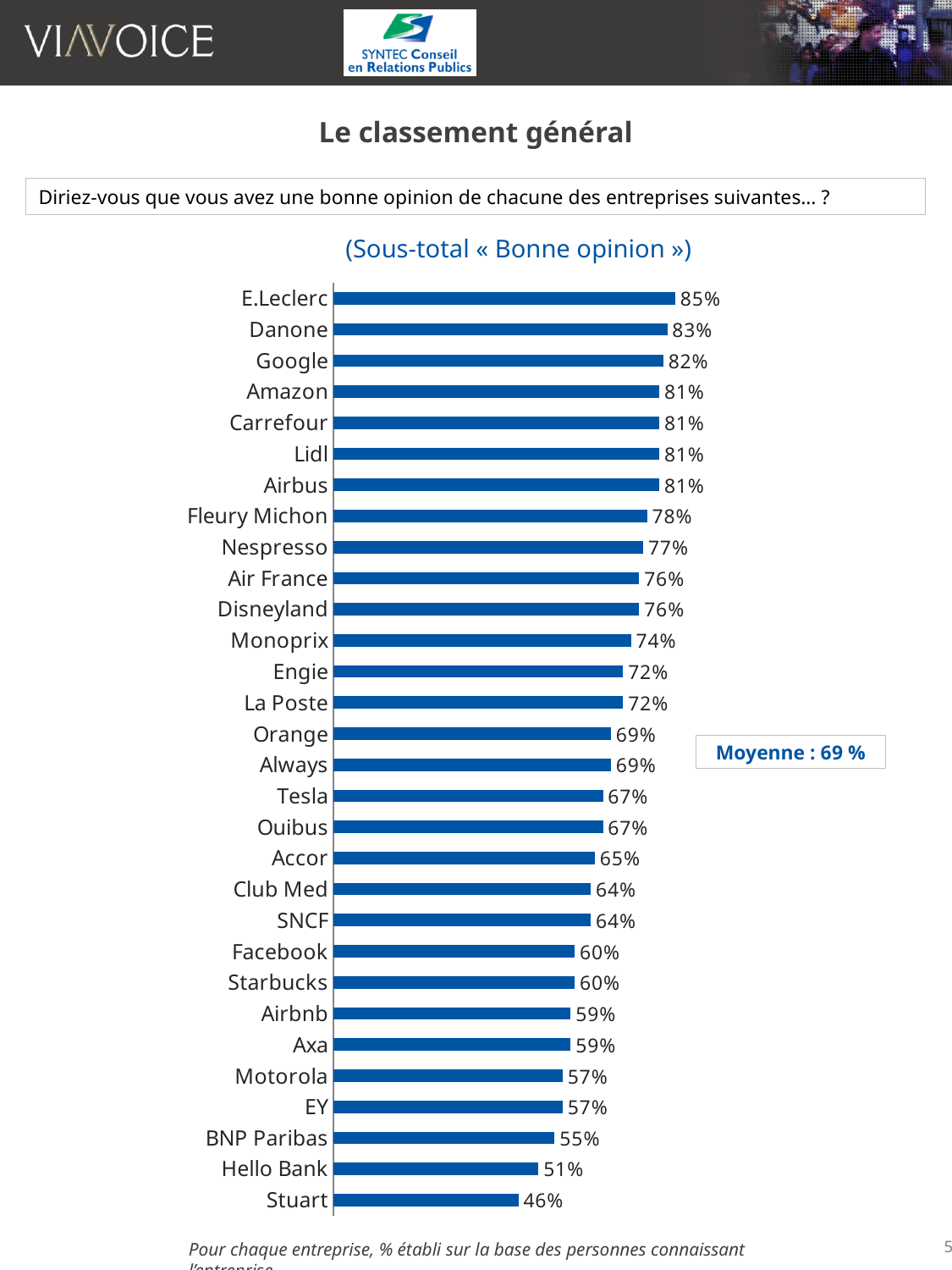
How many companies are shown in the chart? 30 What is the value for Monoprix? 74% What is the difference between the values for Nespresso and Tesla? 10% Which has a larger value, BNP Paribas or Accor? Accor What is the difference between the values for E.Leclerc and Stuart? 39% What is the value for Hello Bank? 51% Which company has the lowest value? Stuart Which company has the highest value? E.Leclerc What kind of chart is shown on the slide? Bar chart Which has a larger value, Facebook or Airbus? Airbus What average (Moyenne) is indicated on the slide? 69 % What is the value for Danone? 83%